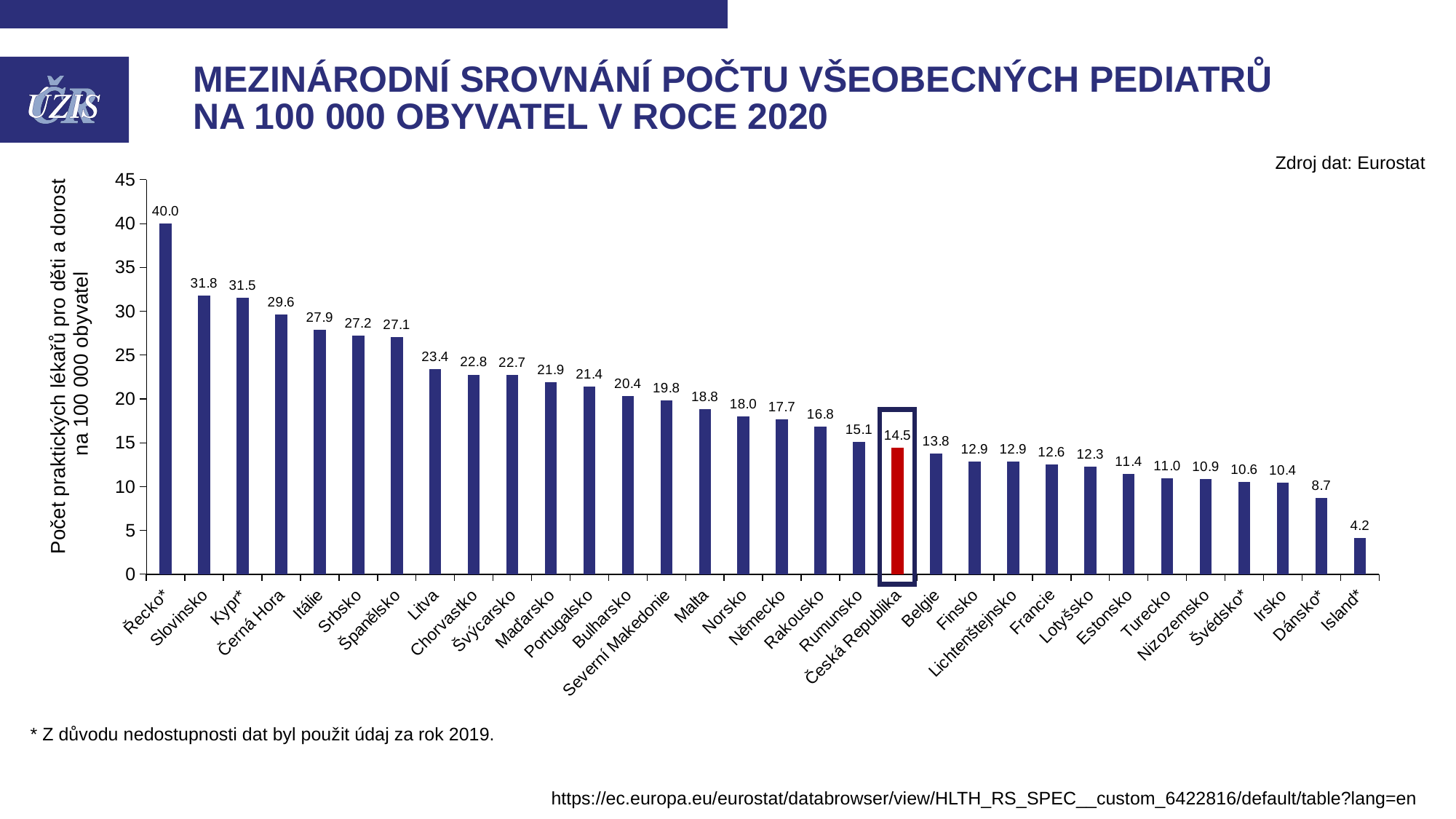
What is the value for Česká Republika? 14.5 What is the difference between the values for Rakousko and Rumunsko? 1.7 What is the value for Německo? 17.7 Which has a larger value, Litva or Belgie? Litva Is the value for Maďarsko greater or less than 20? greater Which bar is highlighted in red on the chart? Česká Republika What is the difference between the values for Řecko* and Česká Republika? 25.5 Which country has the highest value? Řecko* How many countries are shown on the chart? 32 What kind of chart is shown on the slide? bar chart What is the value for Slovinsko? 31.8 Which country has the lowest value? Island*